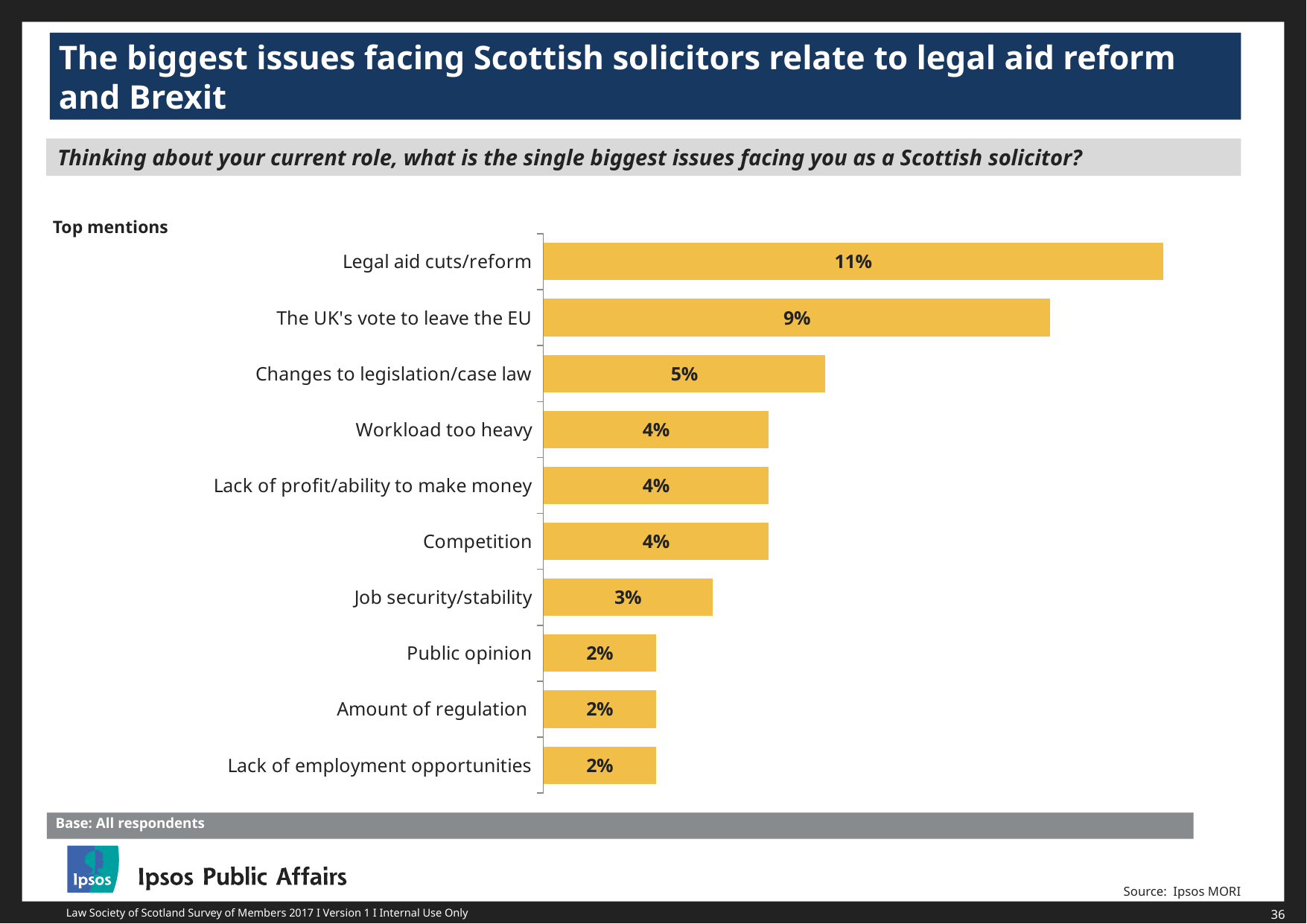
How many issues are listed in the chart? 10 What percentage is shown for 'Changes to legislation/case law'? 5% What is the difference in percentage points between 'Legal aid cuts/reform' and 'The UK's vote to leave the EU'? 2 percentage points What value is shown for 'Public opinion'? 2% What is the base stated for the chart? All respondents Which issue has the highest percentage of mentions? Legal aid cuts/reform Which has a larger value: 'Changes to legislation/case law' or 'Workload too heavy'? Changes to legislation/case law What is the value for 'Job security/stability'? 3% How many issues share the value of 4%? 3 What is the value shown for 'The UK's vote to leave the EU'? 9% What percentage of respondents mentioned legal aid cuts/reform as the biggest issue? 11% What type of chart is used on this slide? Bar chart